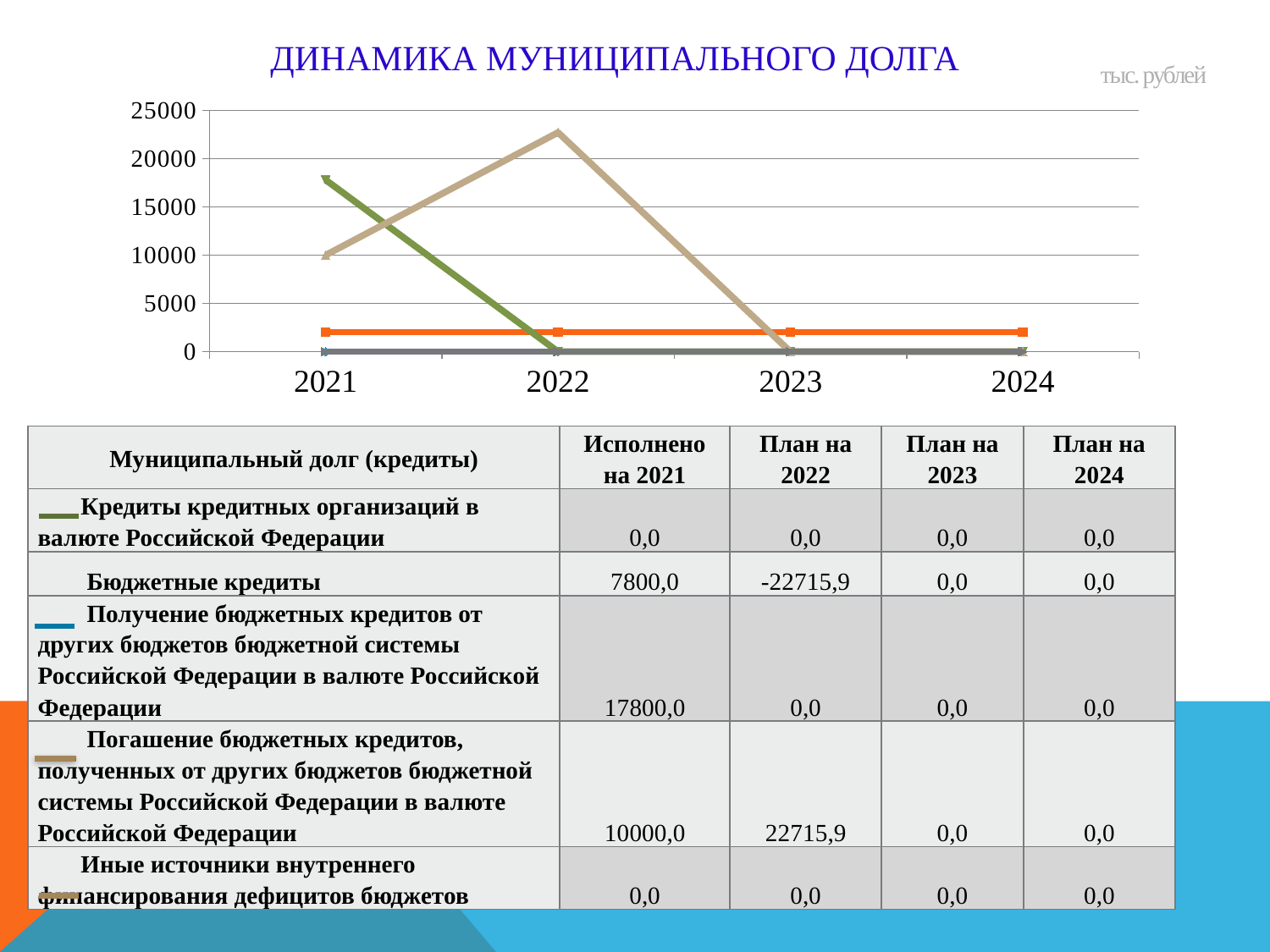
What is the title of the chart on the slide? ДИНАМИКА МУНИЦИПАЛЬНОГО ДОЛГА In the table below the chart, what is the value of 'Бюджетные кредиты' for 'Исполнено на 2021'? 7800,0 Is the value of the orange line in 2023 greater or less than 5000? less How many years are shown along the x axis of the chart? 4 Is the value of the green line in 2021 greater or less than 15000? greater Does the green line rise or fall from 2021 to 2022? falls In the table below the chart, what is the value of 'Погашение бюджетных кредитов, полученных от других бюджетов бюджетной системы Российской Федерации в валюте Российской Федерации' for 'План на 2022'? 22715,9 Does the tan (beige) line rise or fall from 2021 to 2022? rises What is the highest value shown on the chart's vertical axis? 25000 In what units are the chart values given, according to the note at the top right? тыс. рублей Is the value of the tan (beige) line in 2022 greater or less than 20000? greater What kind of chart is shown on the slide? line chart